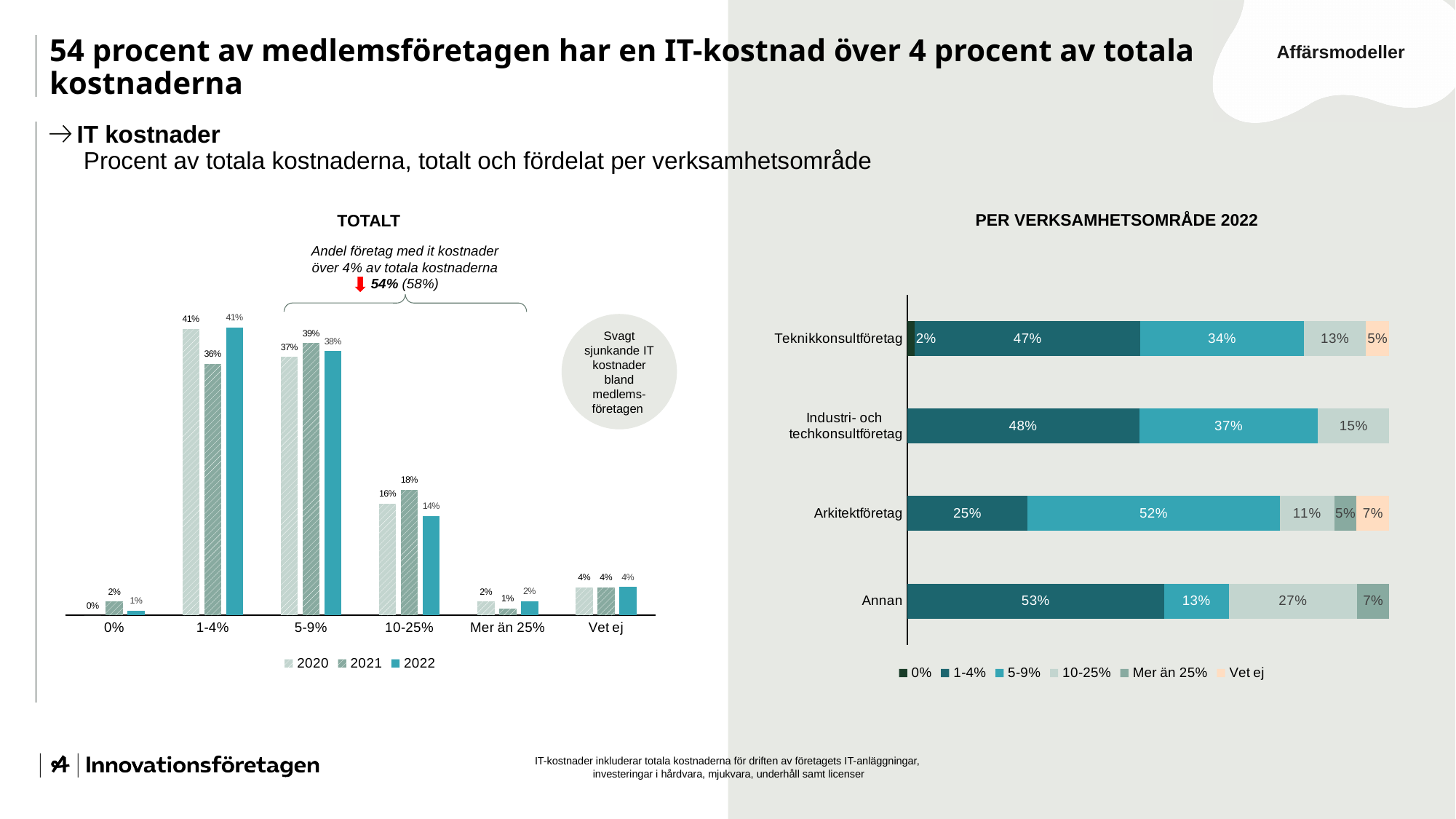
In the TOTALT chart, what is the difference between the 2020 and 2022 values in the 10-25% category? 2% In the TOTALT chart, which category has the highest value for 2021? 5-9% What kind of chart is the PER VERKSAMHETSOMRÅDE 2022 chart? Stacked bar chart In the TOTALT chart, which is larger in the 1-4% category: the 2021 value or the 2022 value? 2022 In the PER VERKSAMHETSOMRÅDE 2022 chart, what is the 1-4% share for Annan? 53% In the PER VERKSAMHETSOMRÅDE 2022 chart, how many series does the legend list? 6 In the TOTALT chart, what is the value for 2022 in the 5-9% category? 38% In the PER VERKSAMHETSOMRÅDE 2022 chart, what is the 5-9% share for Arkitektföretag? 52% In the TOTALT chart, what is the value for 2021 in the 10-25% category? 18% In the TOTALT chart, how many series does the legend list? 3 In the TOTALT chart, how many categories are shown on the x axis? 6 In the PER VERKSAMHETSOMRÅDE 2022 chart, which business area has the highest 1-4% share? Annan